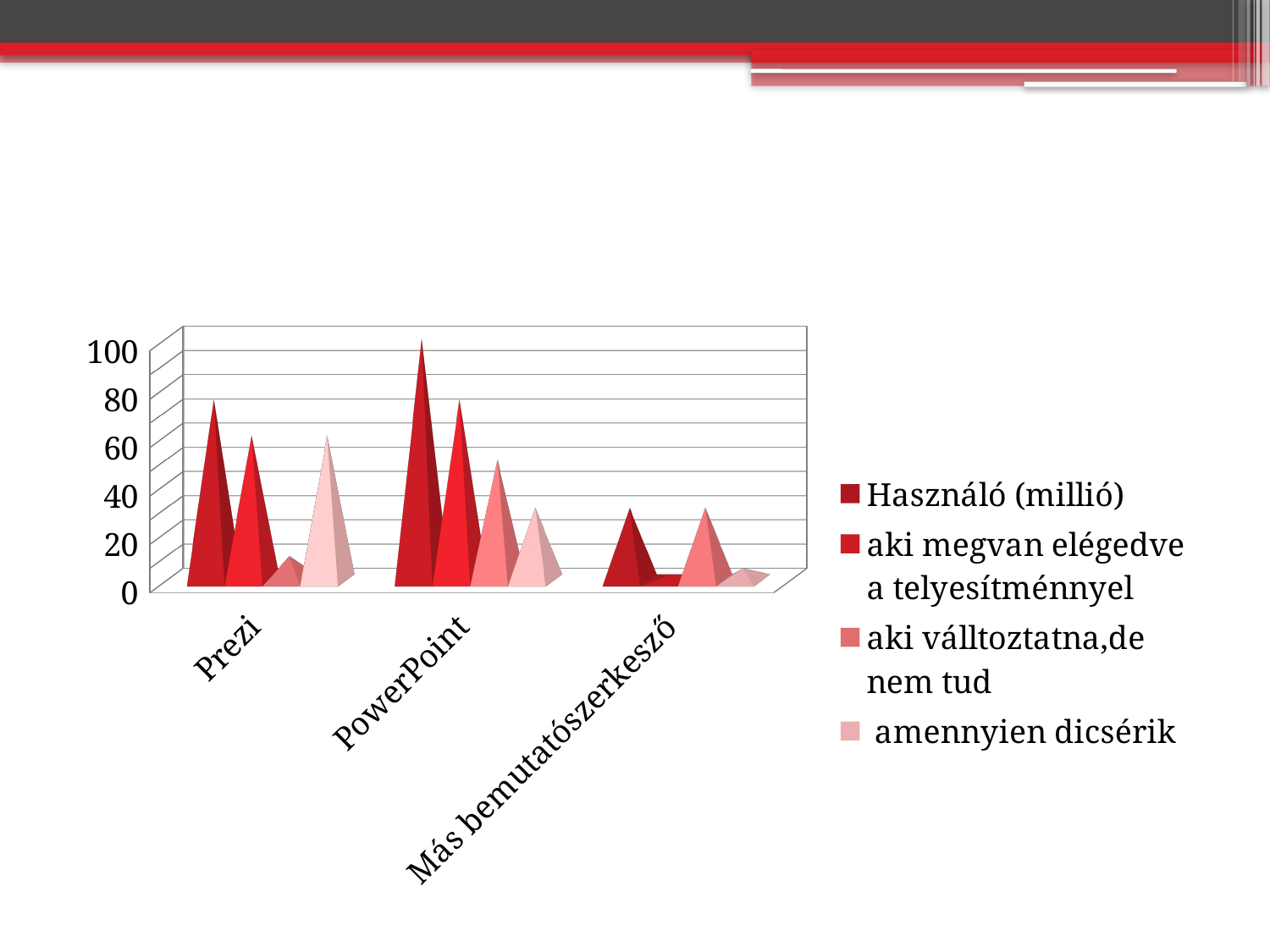
Which series is shown in the lightest pink colour in the legend? amennyien dicsérik For Prezi, which is larger: aki válltoztatna,de nem tud or amennyien dicsérik? amennyien dicsérik Which category has the highest value for the series amennyien dicsérik? Prezi How many categories are shown on the x axis of the chart? 3 Which category has the lowest value for the series Használó (millió)? Más bemutatószerkesző Is the value of Használó (millió) for Prezi greater or less than 60? greater Which category has the lowest value for the series aki megvan elégedve a telyesítménnyel? Más bemutatószerkesző How many series does the chart's legend list? 4 Is the value of Használó (millió) for Más bemutatószerkesző greater or less than 60? less Which category has the highest value for the series Használó (millió)? PowerPoint Is the value of aki válltoztatna,de nem tud for Prezi greater or less than 20? less What kind of chart is shown on the slide? bar chart